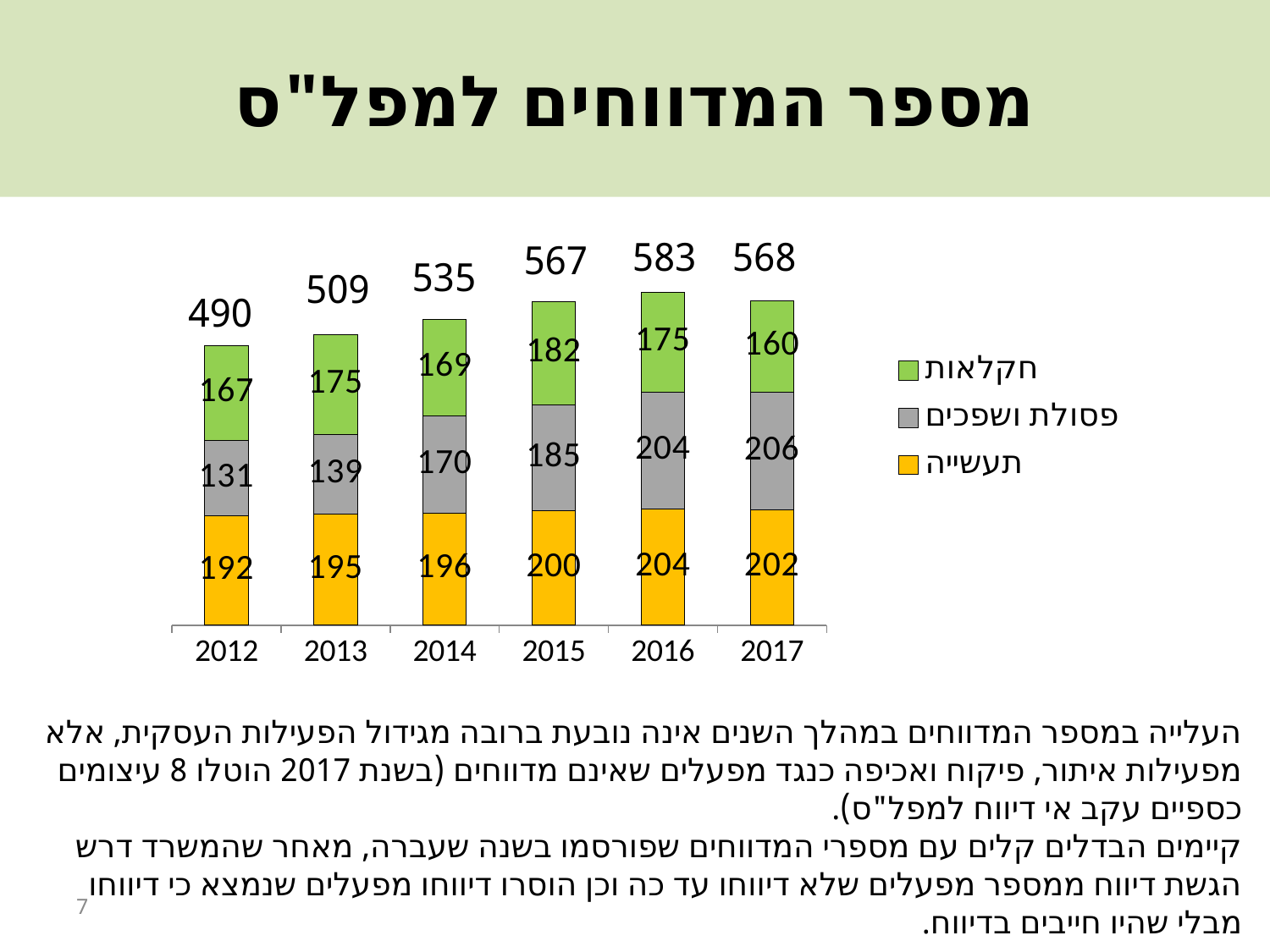
What is the value for תעשייה in 2012? 192 What type of chart is shown on the slide? Stacked bar chart Which series is shown in green in the legend? חקלאות What is the value for חקלאות in 2015? 182 What is the total of the stacked bar for 2016? 583 Which year has the lowest total number of reporters? 2012 How many years are shown on the x axis? 6 How many series does the legend list? 3 What is the difference between the totals for 2017 and 2012? 78 Which year has the highest total number of reporters? 2016 What is the value for פסולת ושפכים in 2017? 206 Which is larger in 2014: the value for פסולת ושפכים or the value for חקלאות? פסולת ושפכים